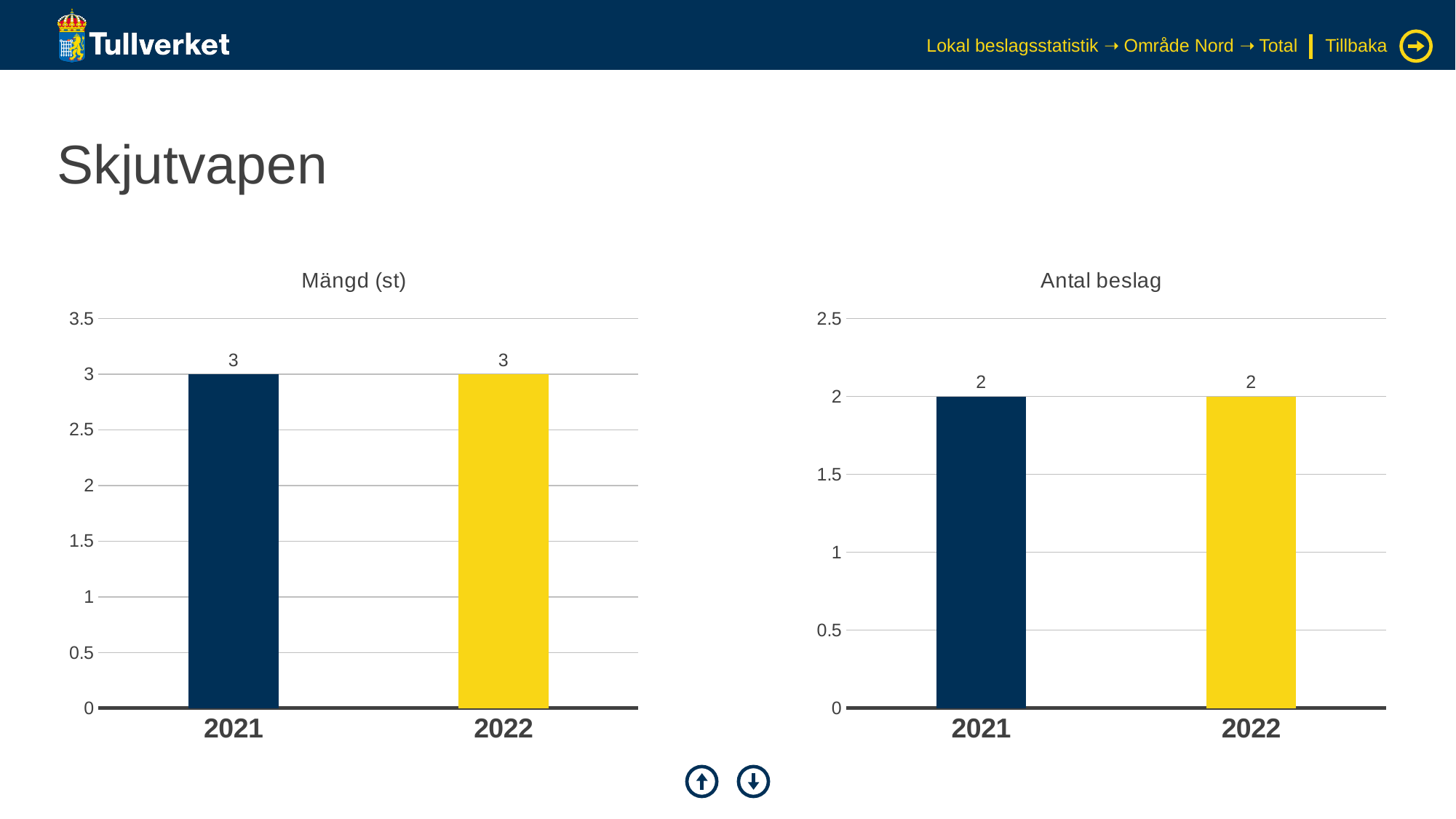
In the 'Mängd (st)' chart, what is the value for 2022? 3 What kind of chart is the 'Antal beslag' chart? Bar chart In the 'Antal beslag' chart, what is the value for 2021? 2 In the 'Mängd (st)' chart, how many categories are shown on the x axis? 2 In the 'Antal beslag' chart, is the value for 2021 greater or less than 1.5? greater In the 'Mängd (st)' chart, what is the value for 2021? 3 In the 'Mängd (st)' chart, what is the difference between the values for 2021 and 2022? 0 In the 'Antal beslag' chart, what is the difference between the values for 2022 and 2021? 0 In the 'Mängd (st)' chart, do the values rise, fall or stay the same from 2021 to 2022? Stay the same In the 'Antal beslag' chart, what is the value for 2022? 2 In the 'Antal beslag' chart, how many bars are plotted? 2 What is the title of the chart on the right side of the slide? Antal beslag